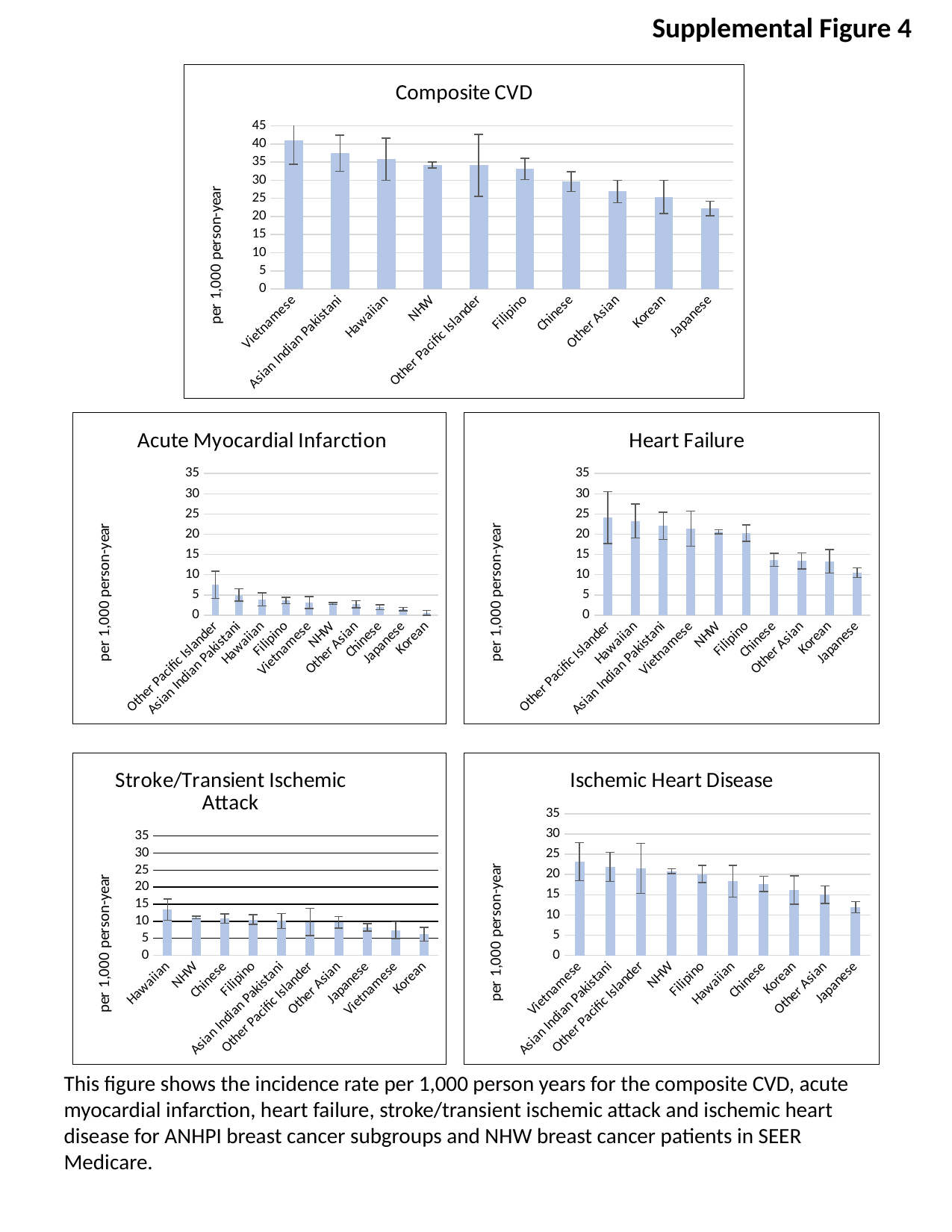
In the Heart Failure chart, is the value for Chinese greater or less than 15? less In the Composite CVD chart, is the value for Japanese greater or less than 25? less In the Stroke/Transient Ischemic Attack chart, which category has the highest value? Hawaiian In the Composite CVD chart, which category has the highest value? Vietnamese In the Composite CVD chart, how many categories are plotted? 10 In the Ischemic Heart Disease chart, is the value for Japanese greater or less than 15? less In the Heart Failure chart, which is larger, the value for Filipino or the value for Chinese? Filipino In the Composite CVD chart, which category has the lowest value? Japanese In the Composite CVD chart, do the values rise or fall from left to right along the x axis? fall How many charts are shown on the slide? 5 In the Acute Myocardial Infarction chart, which category has the lowest value? Korean In the Acute Myocardial Infarction chart, which category has the highest value? Other Pacific Islander